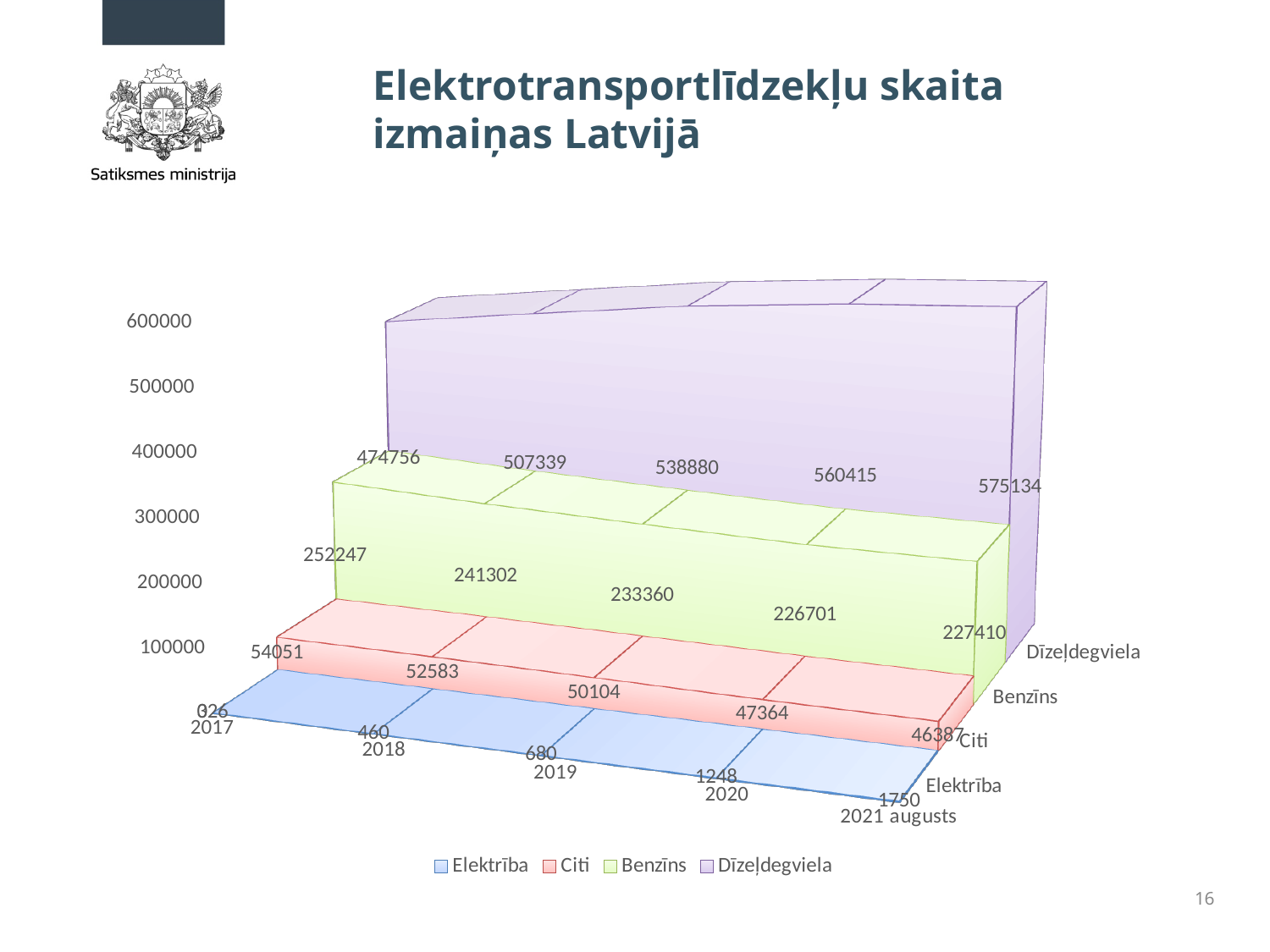
How many series does the legend list? 4 What is the value for Dīzeļdegviela in 2020? 560415 What is the value for Elektrība in 2021 augusts? 1750 In which year is the Dīzeļdegviela value highest? 2021 augusts What kind of chart is shown on the slide? 3D area chart What is the difference between the Dīzeļdegviela values for 2021 augusts and 2017? 100378 Does the Elektrība series rise or fall from 2018 to 2021 augusts? rise What is the value for Benzīns in 2017? 252247 In which year is the Citi value lowest? 2021 augusts How many years are shown on the x axis? 5 What is the value for Citi in 2019? 50104 Which is larger, the Benzīns value for 2020 or for 2021 augusts? 2021 augusts